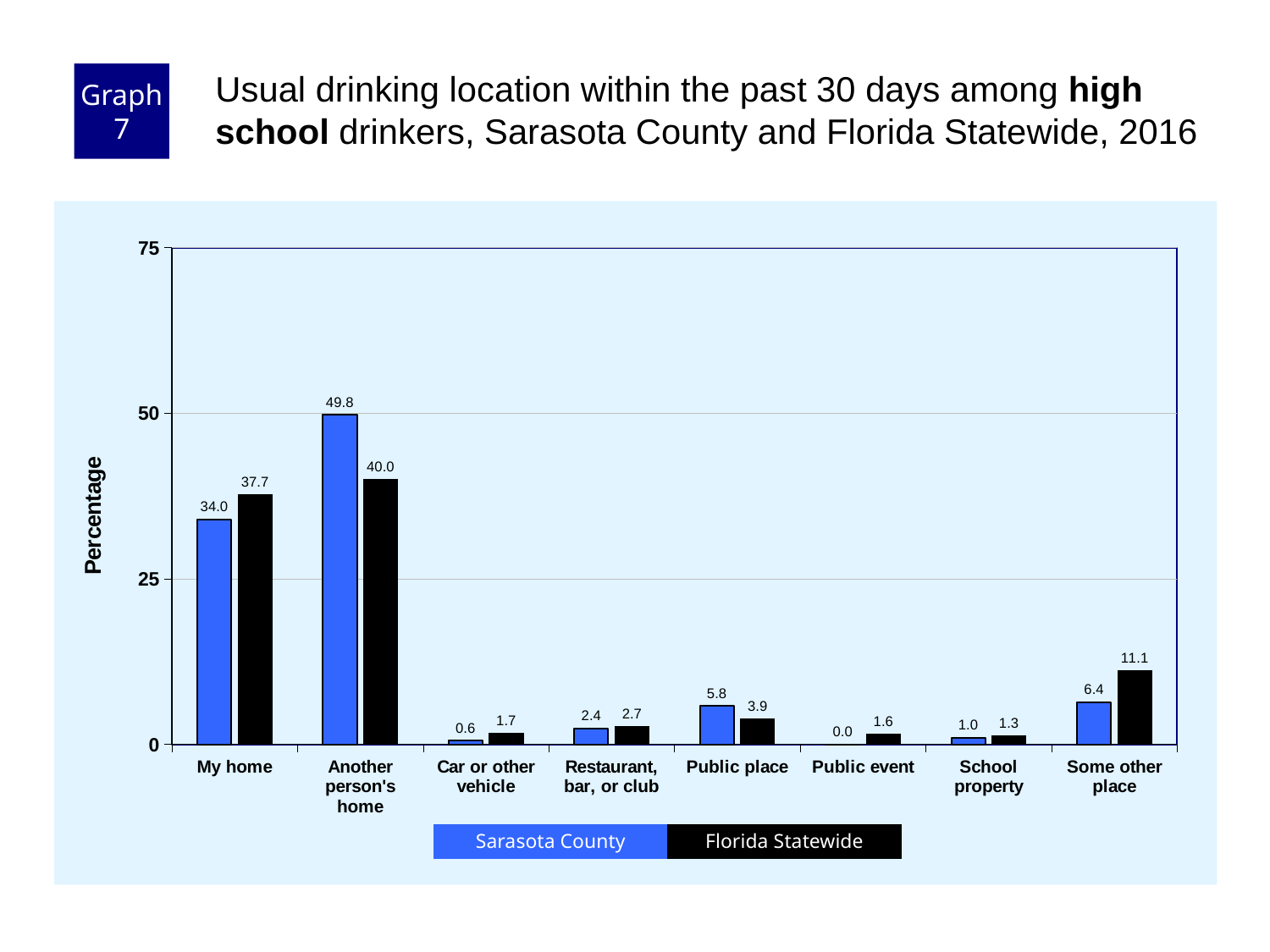
What kind of chart is shown on the slide? Bar chart What is the difference between the Sarasota County and Florida Statewide values for "Another person's home"? 9.8 How many series does the legend list? 2 Which is larger for "Some other place": Sarasota County or Florida Statewide? Florida Statewide What is the Sarasota County value for "Public event"? 0.0 Which category has the highest Florida Statewide value? Another person's home What is the Sarasota County value for "Another person's home"? 49.8 What is the Florida Statewide value for "My home"? 37.7 Is the Sarasota County value for "My home" greater or less than 25? greater How many location categories are shown on the x axis? 8 Which category has the lowest Sarasota County value? Public event What colour represents Sarasota County in the chart? Blue